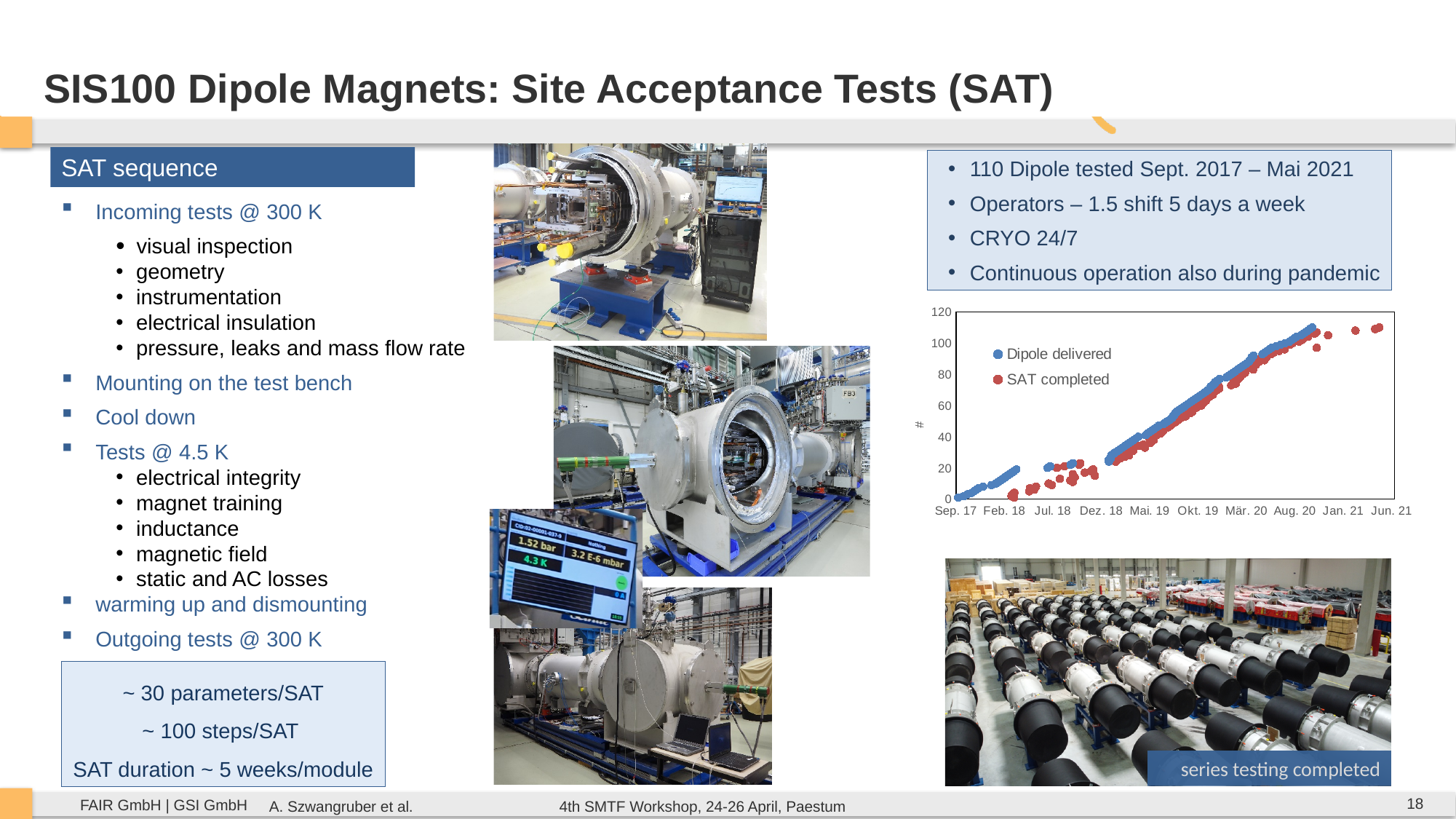
Is the value of 'SAT completed' at Jul. 18 greater or less than 20? less How many series does the chart legend list? 2 What is the maximum value shown on the chart's y axis? 120 Is the value of 'SAT completed' at Jun. 21 greater or less than 100? greater Do the values of the 'SAT completed' series rise or fall over time in the chart? rise Is the value of 'Dipole delivered' at Mär. 20 greater or less than 60? greater What kind of chart is shown on the slide? scatter chart At Jul. 18, which series has the larger value, 'Dipole delivered' or 'SAT completed'? Dipole delivered Which colour represents the 'SAT completed' series in the chart? red Do the values of the 'Dipole delivered' series rise or fall along the x axis from Sep. 17 to Jun. 21? rise What are the two series named in the chart legend? Dipole delivered and SAT completed